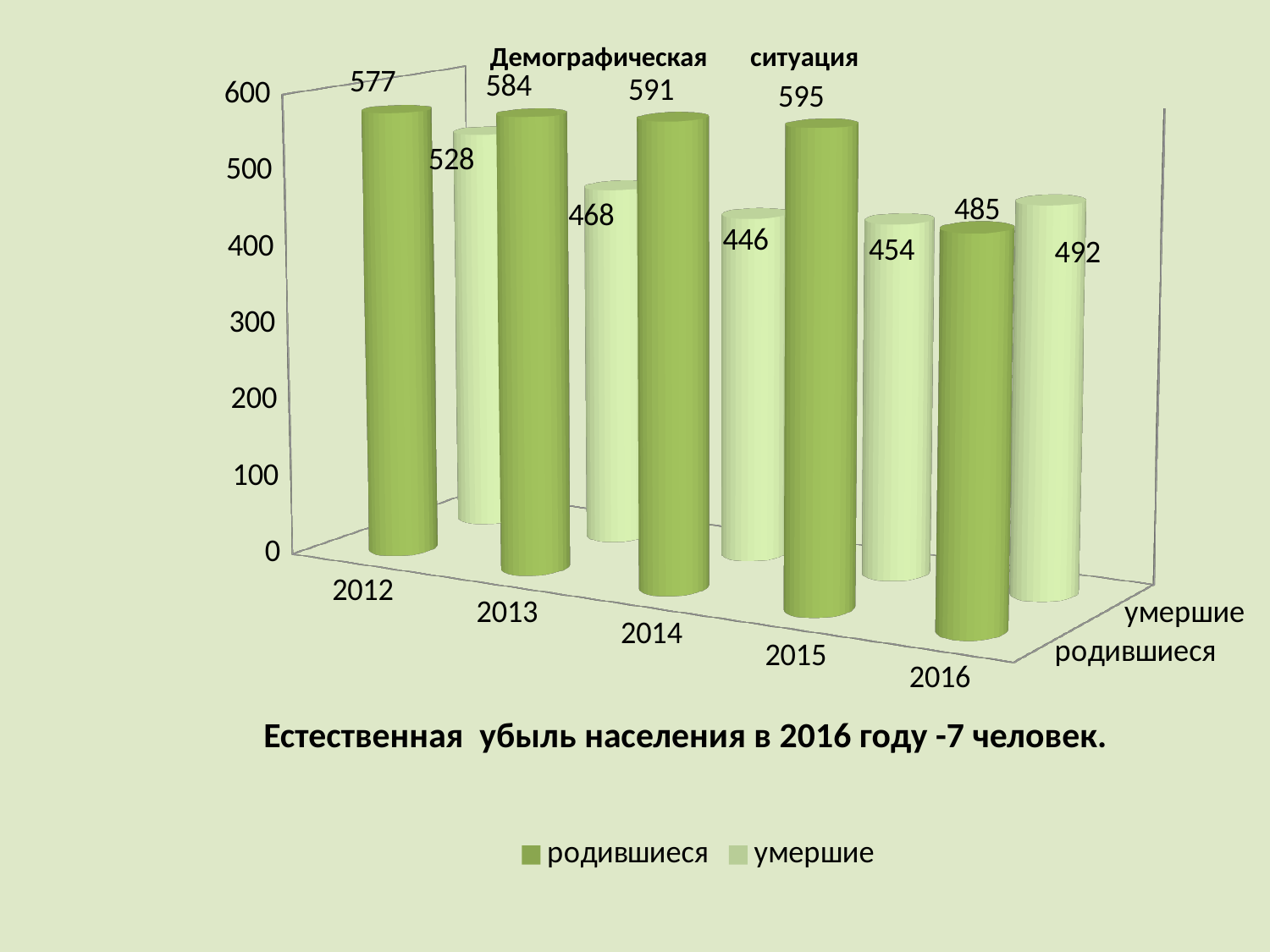
Which is larger in 2013, родившиеся or умершие? родившиеся What is the value for родившиеся in 2014? 591 What is the value for умершие in 2016? 492 How many years are shown on the x axis? 5 How many series does the legend list? 2 In which year is the value for умершие lowest? 2014 What is the difference between родившиеся and умершие in 2016? 7 What is the value for умершие in 2012? 528 In which year is the value for родившиеся highest? 2015 What is the difference between родившиеся and умершие in 2015? 141 Which is larger in 2016, родившиеся or умершие? умершие What kind of chart is shown on the slide? bar chart